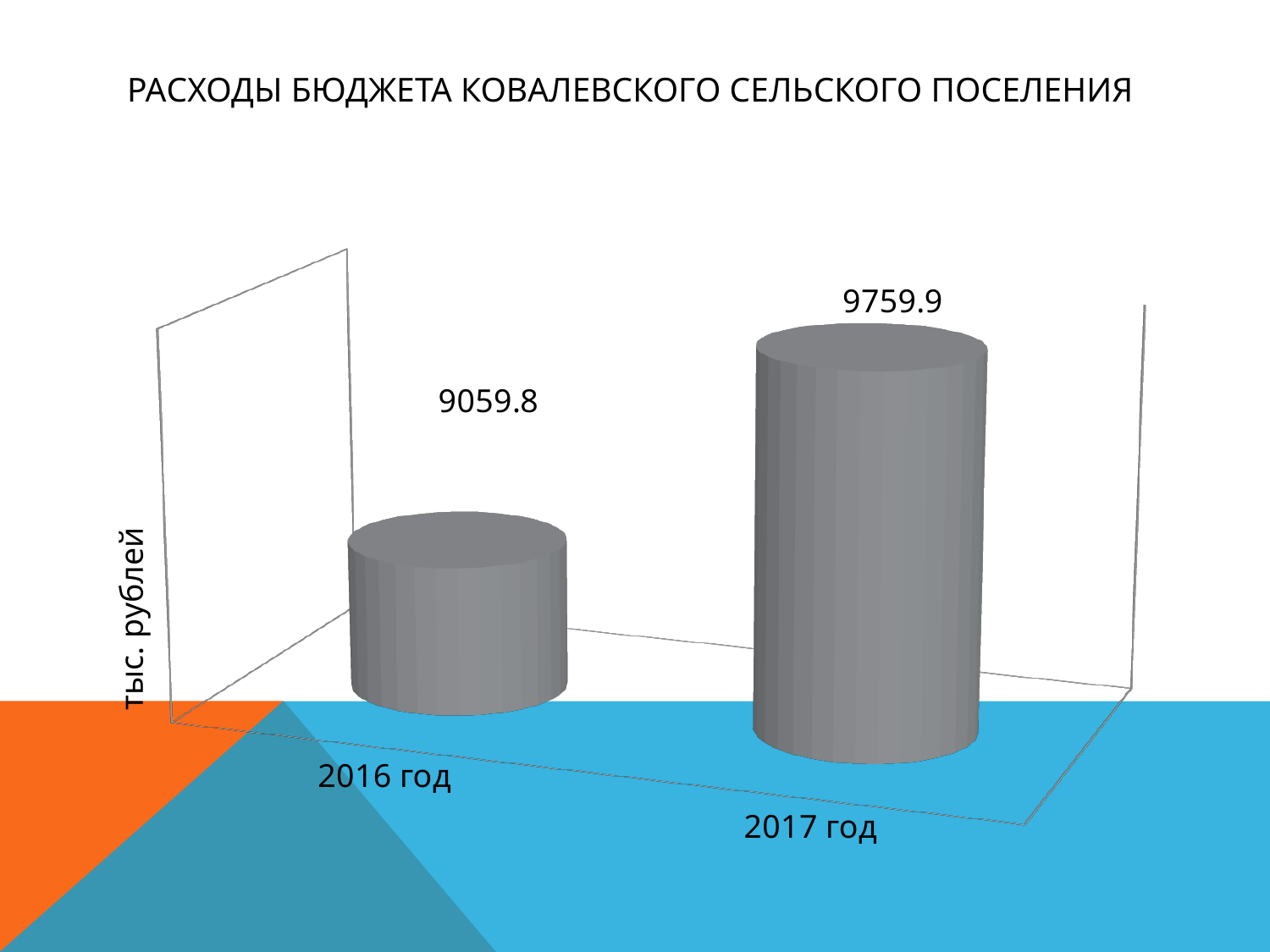
What is the value for 2016 год? 9059.8 What is the label of the vertical axis? тыс. рублей Which is larger, the value for 2016 год or 2017 год? 2017 год What kind of chart is shown on the slide? bar chart What is the difference between the values for 2017 год and 2016 год? 700.1 Which year has the highest value? 2017 год What is the value for 2017 год? 9759.9 How many categories are shown in the chart? 2 Do the values rise or fall from 2016 год to 2017 год? rise What is the title of the chart? РАСХОДЫ БЮДЖЕТА КОВАЛЕВСКОГО СЕЛЬСКОГО ПОСЕЛЕНИЯ Which year has the lowest value? 2016 год